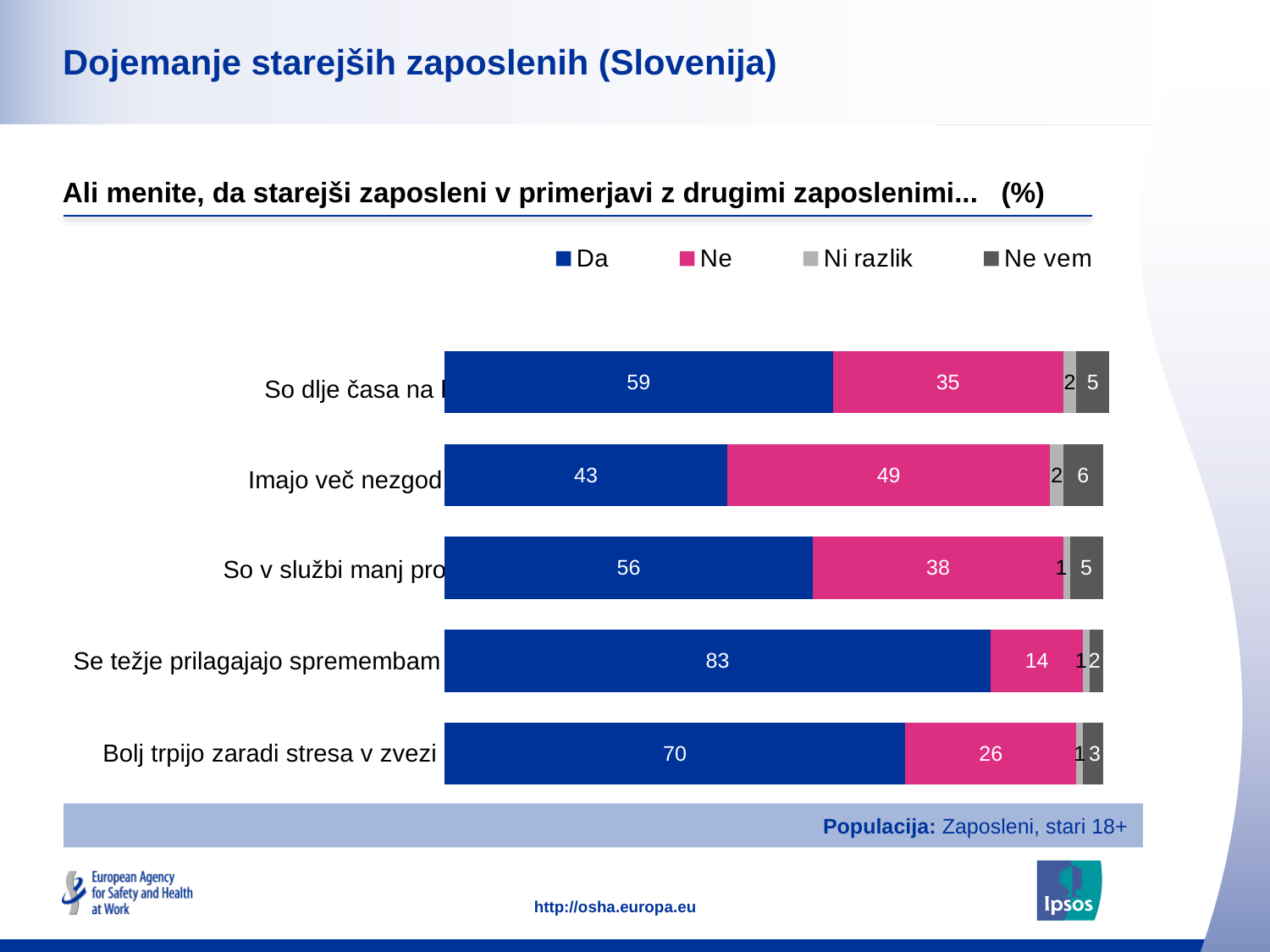
What is the difference between the 'Da' and 'Ne' values for 'Bolj trpijo zaradi stresa v zvezi'? 44 What kind of chart is shown on the slide? stacked bar chart How many series does the legend list? 4 Which statement has the lowest 'Da' value? Imajo več nezgod How many categories (statements) are plotted in the chart? 5 What is the 'Ne vem' value for 'Bolj trpijo zaradi stresa v zvezi'? 3 For 'Imajo več nezgod', which is larger, the 'Da' value or the 'Ne' value? Ne What is the total of the stacked bar for 'Se težje prilagajajo spremembam'? 100 Which legend entry is shown in pink? Ne What is the 'Da' value for 'Imajo več nezgod'? 43 Which statement has the highest 'Da' value? Se težje prilagajajo spremembam What is the 'Ne' value for 'Se težje prilagajajo spremembam'? 14